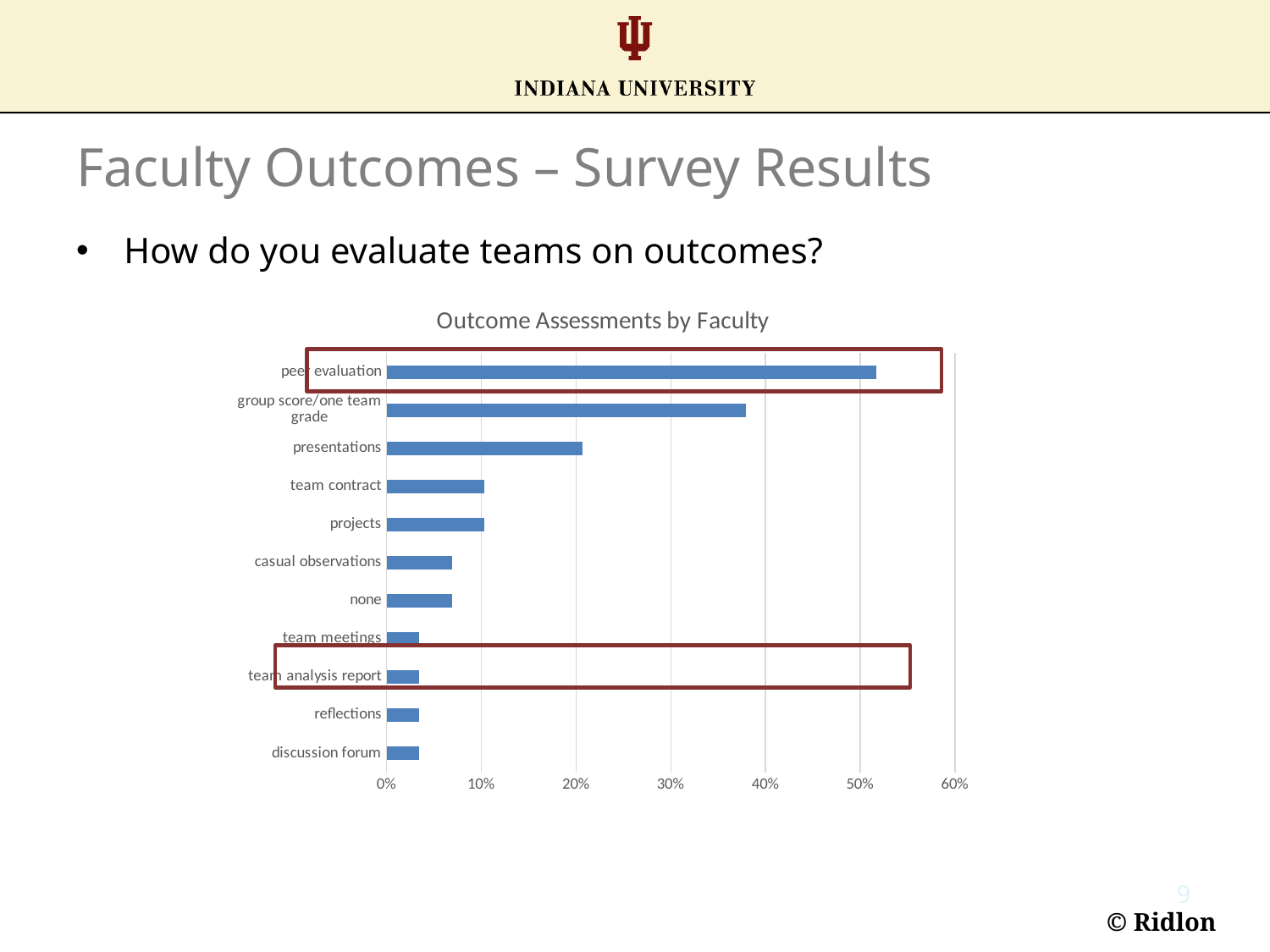
Is the value for group score/one team grade greater or less than 40%? less Is the value for casual observations greater or less than 10%? less How many categories are plotted in the chart? 11 What is the highest value shown on the horizontal axis? 60% Is the value for peer evaluation greater or less than 50%? greater Which is larger, the value for presentations or the value for team contract? presentations Which is larger, the value for group score/one team grade or the value for peer evaluation? peer evaluation What is the title of the chart? Outcome Assessments by Faculty Do the bar values rise or fall going from the top category to the bottom category? fall What type of chart is shown on the slide? bar chart Which category has the highest value in the chart? peer evaluation